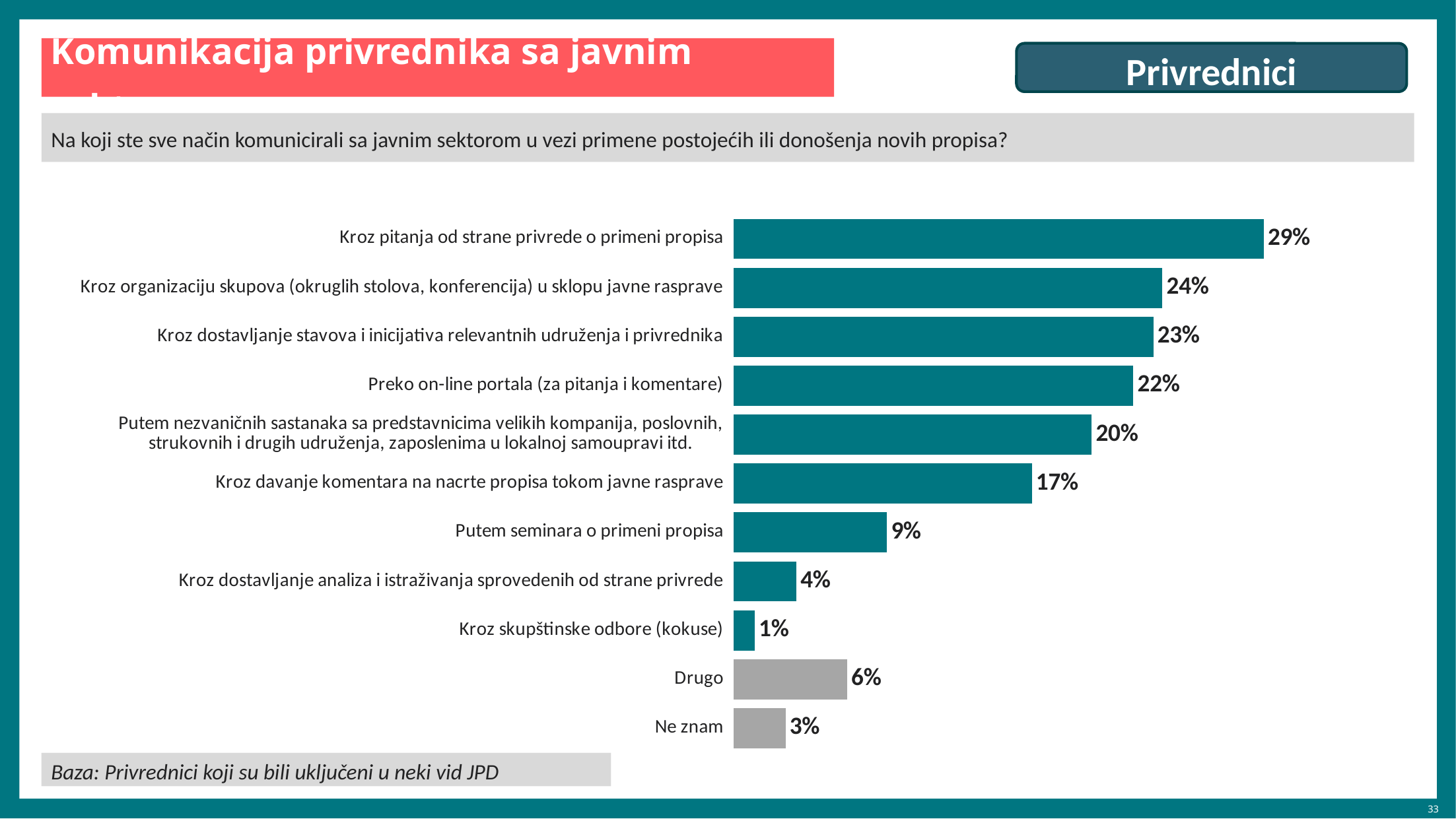
Which is larger: "Putem seminara o primeni propisa" or "Drugo"? Putem seminara o primeni propisa What is the value for "Preko on-line portala (za pitanja i komentare)"? 22% Which category has the highest value? Kroz pitanja od strane privrede o primeni propisa Which category has the lowest value? Kroz skupštinske odbore (kokuse) What is the value for "Drugo"? 6% What is the value for "Kroz pitanja od strane privrede o primeni propisa"? 29% What is the value for "Kroz skupštinske odbore (kokuse)"? 1% Which two categories are shown with grey bars instead of teal? Drugo and Ne znam What is the value for "Putem nezvaničnih sastanaka sa predstavnicima velikih kompanija, poslovnih, strukovnih i drugih udruženja, zaposlenima u lokalnoj samoupravi itd."? 20% How many categories are shown in the chart? 11 What is the difference between "Kroz organizaciju skupova (okruglih stolova, konferencija) u sklopu javne rasprave" and "Kroz davanje komentara na nacrte propisa tokom javne rasprave"? 7% What kind of chart is shown on the slide? Bar chart